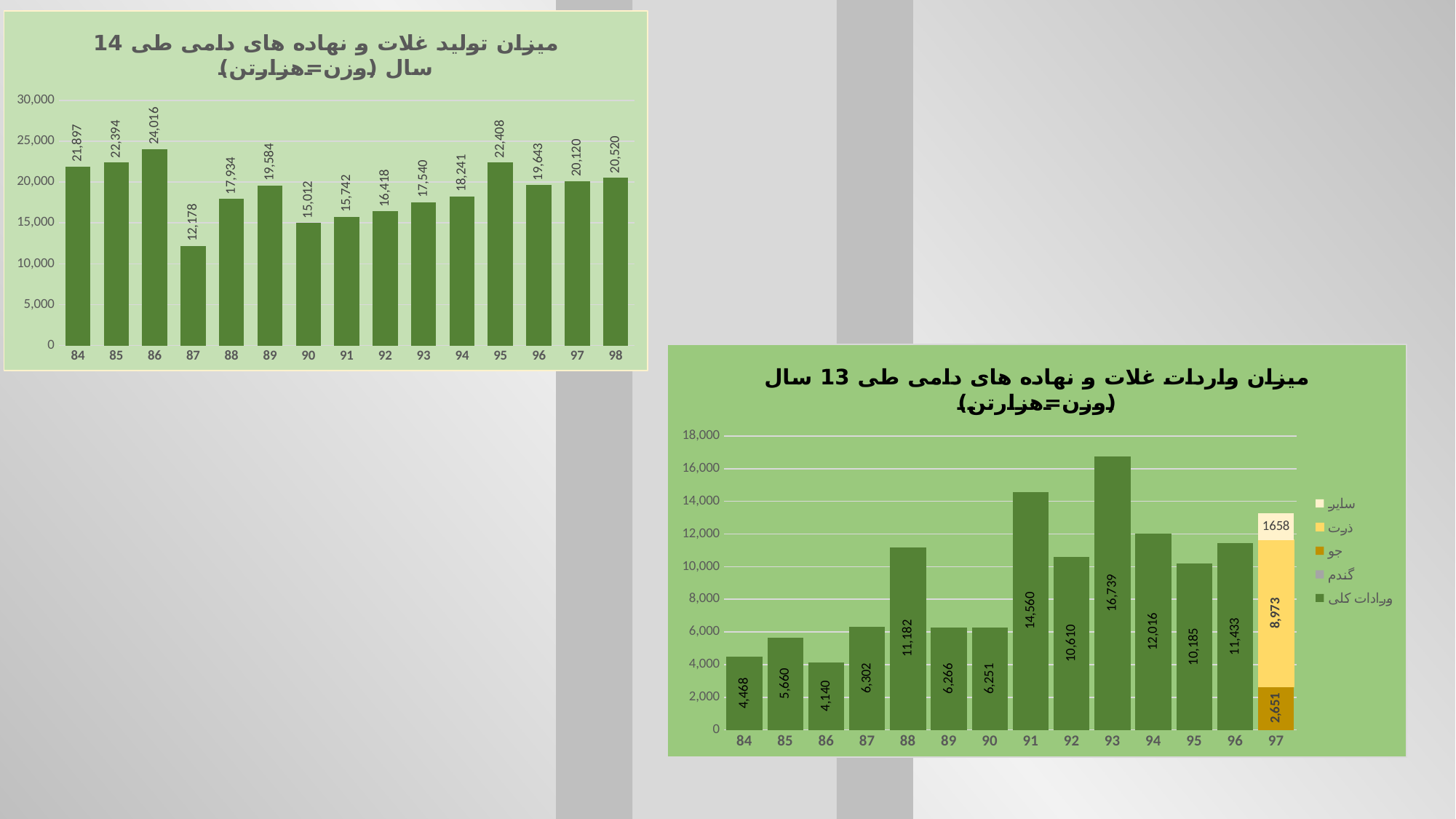
In the top-left chart, which year has the lowest value? 87 What kind of chart is the bottom-right chart? bar chart How many bars (years) are shown in the top-left chart? 15 In the top-left chart, what is the difference between the values for year 86 and year 87? 11,838 In the bottom-right chart, what is the total of the stacked bar for year 97? 13,282 In the bottom-right chart, what is the difference between the values for year 93 and year 91? 2,179 In the bottom-right chart, what is the value for year 93? 16,739 In the top-left chart, what is the value for year 86? 24,016 In the top-left chart, is the value for year 90 greater or less than 15,000? greater In the top-left chart, which year has the highest value? 86 How many series does the legend of the bottom-right chart list? 5 In the bottom-right chart, which year has the lowest value? 86